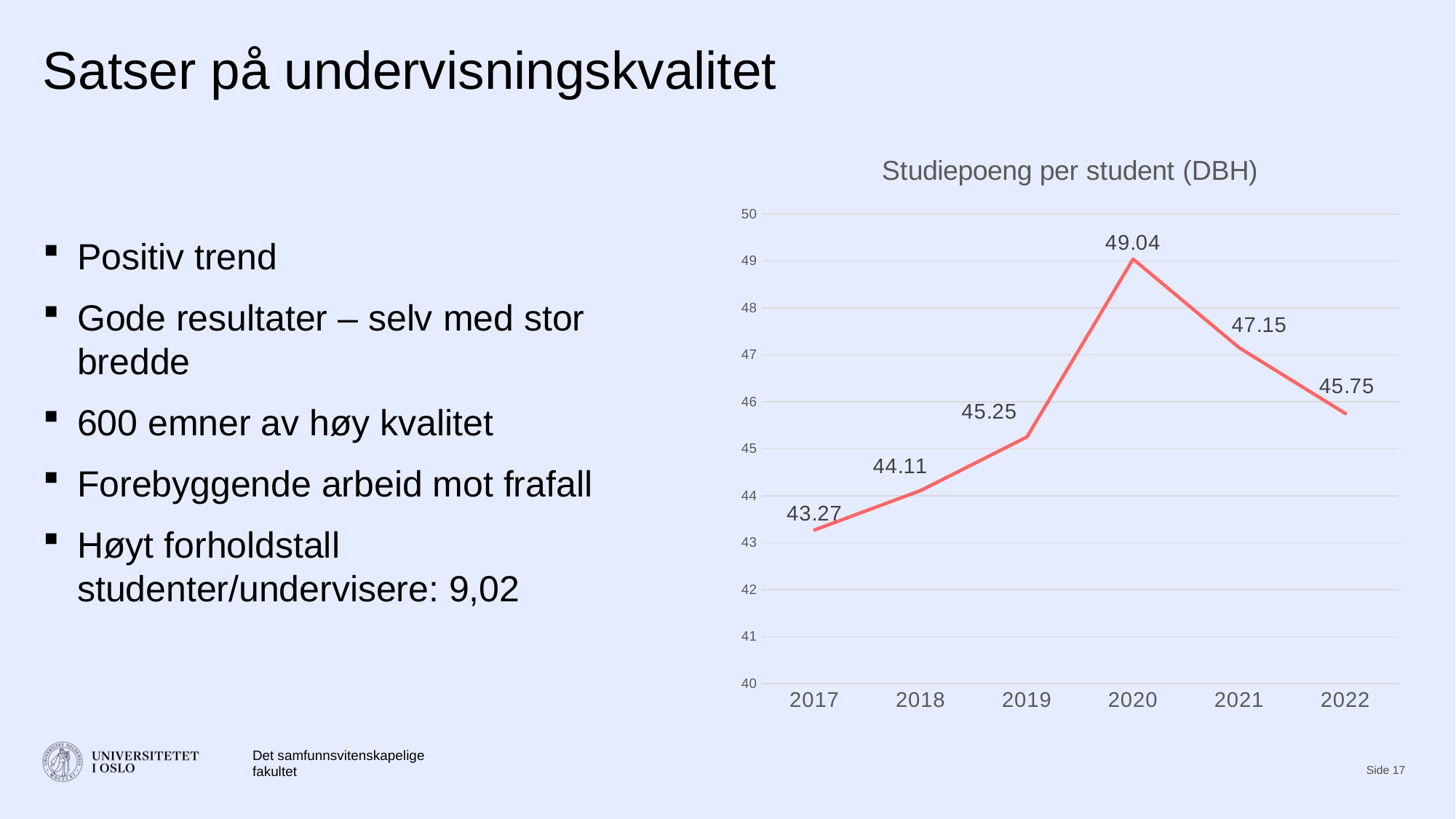
Which year has the lowest value? 2017 What is the value for 2017? 43.27 Which is larger, the value for 2021 or the value for 2022? 2021 How many years are plotted on the chart? 6 Do the values rise or fall from 2017 to 2020? rise What is the value for 2020? 49.04 What is the value for 2022? 45.75 What is the title of the chart? Studiepoeng per student (DBH) Is the value for 2018 greater or less than 45? less Which year has the highest value? 2020 What kind of chart is shown? line chart What is the difference between the values for 2020 and 2019? 3.79